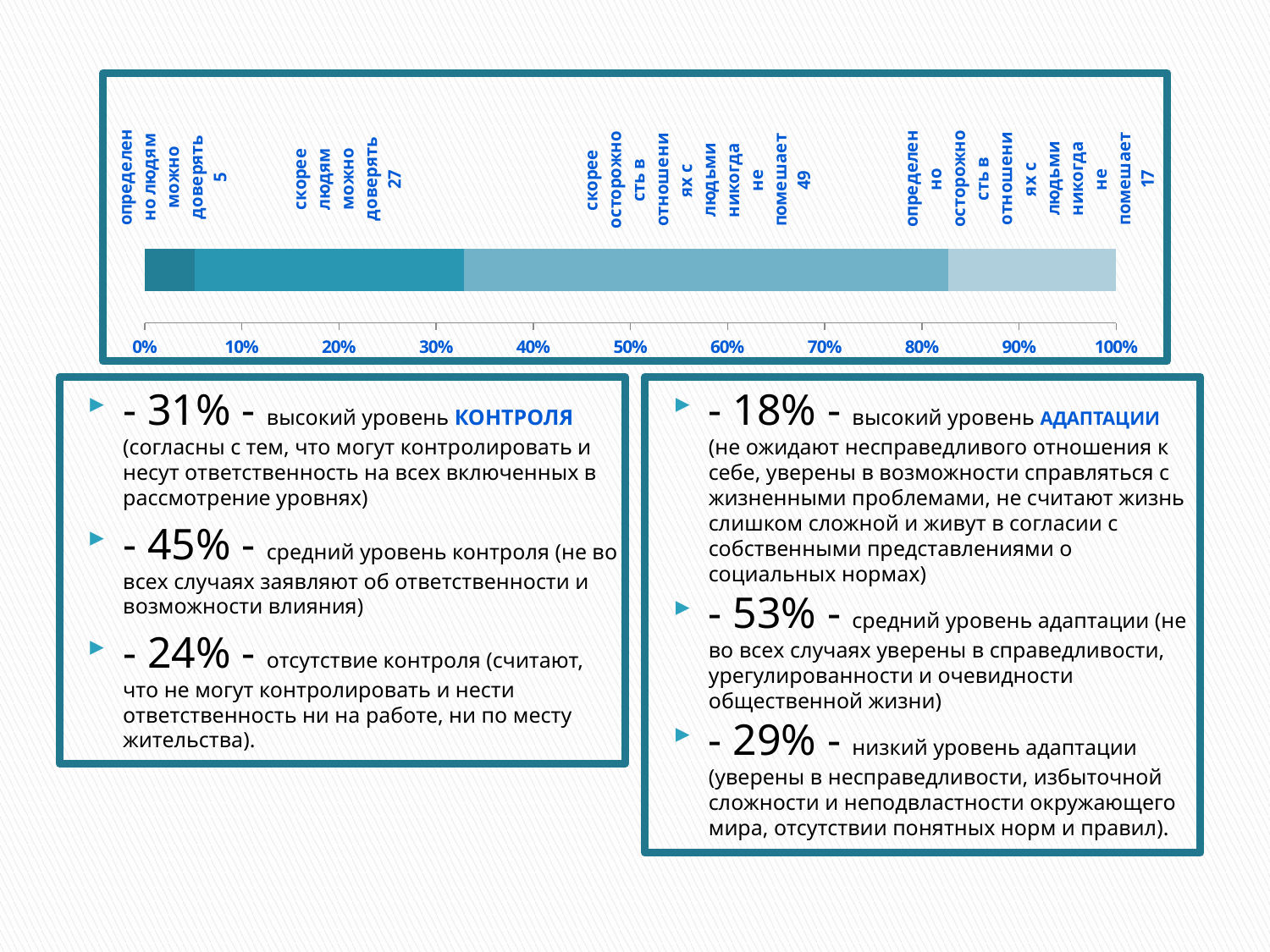
What is the value for "определенно людям можно доверять"? 5 Which is larger: the value for "скорее людям можно доверять" or for "определенно осторожность в отношениях с людьми никогда не помешает"? скорее людям можно доверять Which segment has the lowest value? определенно людям можно доверять Which segment has the highest value? скорее осторожность в отношениях с людьми никогда не помешает What is the value for "скорее осторожность в отношениях с людьми никогда не помешает"? 49 How many segments does the stacked bar contain? 4 What is the difference between the values for "скорее осторожность в отношениях с людьми никогда не помешает" and "скорее людям можно доверять"? 22 What is the highest tick label shown on the horizontal axis? 100% What kind of chart is shown on the slide? bar chart What is the total of the four labelled segment values in the stacked bar? 98 What is the value for "скорее людям можно доверять"? 27 What is the value for "определенно осторожность в отношениях с людьми никогда не помешает"? 17